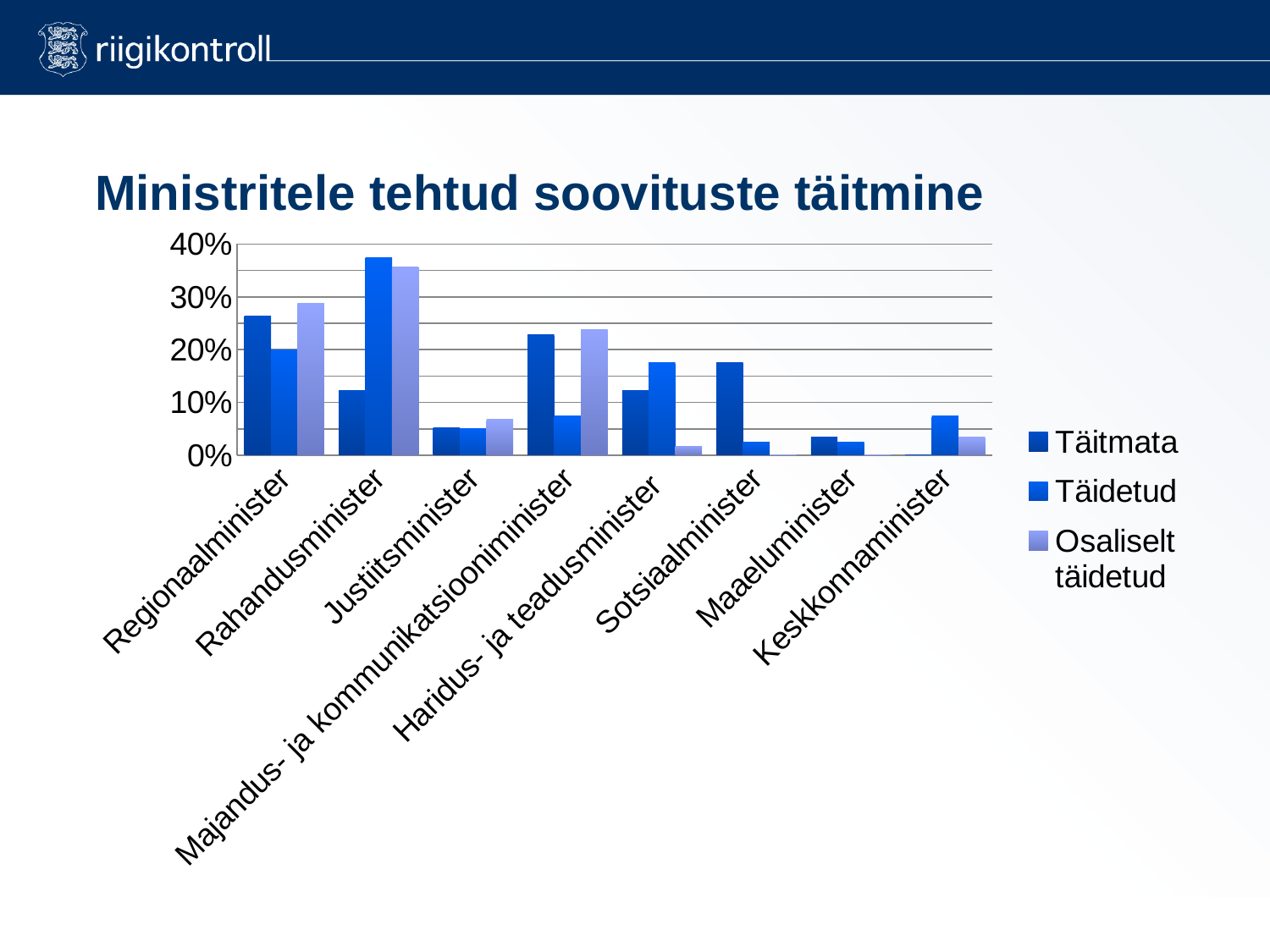
How many series does the chart's legend list? 3 What is the title of the chart? Ministritele tehtud soovituste täitmine What kind of chart is shown on the slide? bar chart Is the Täitmata value for Justiitsminister greater or less than 10%? less Is the Täidetud value for Rahandusminister greater or less than 30%? greater Which minister has the highest Täitmata value? Regionaalminister Is the Osaliselt täidetud value for Regionaalminister greater or less than 20%? greater How many ministers (categories) are shown on the x axis of the chart? 8 Which series is listed last in the chart's legend? Osaliselt täidetud Which is larger for Haridus- ja teadusminister: the Täidetud value or the Osaliselt täidetud value? Täidetud Which is larger for Sotsiaalminister: the Täitmata value or the Täidetud value? Täitmata Which minister has the highest Täidetud value? Rahandusminister